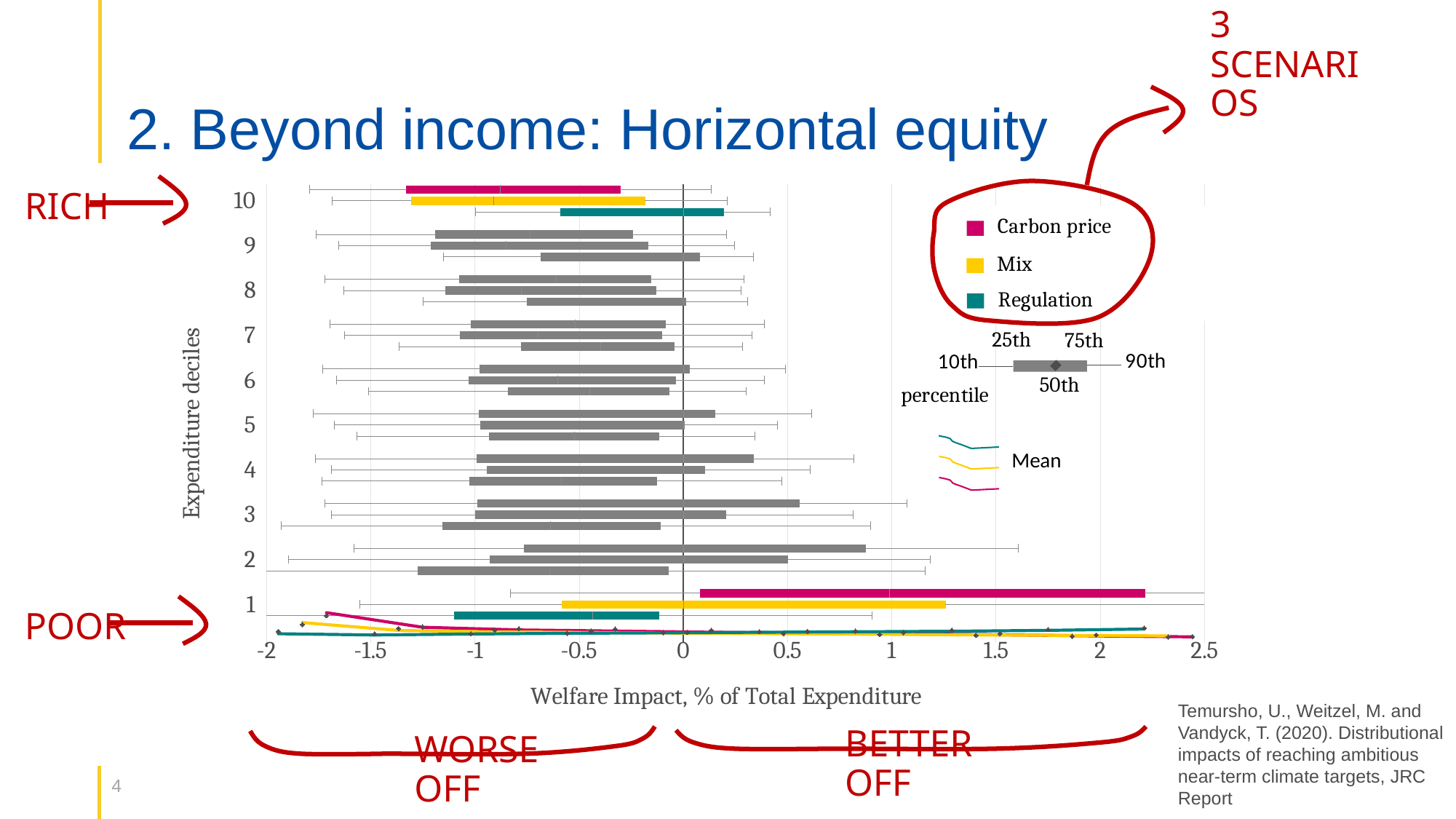
Is the right end of the Mix bar for decile 1 greater or less than 1? greater Is the right end of the Regulation bar for decile 1 greater or less than 0? less Is the right end of the Carbon price bar for decile 1 greater or less than 2? greater Which scenario is shown in yellow in the chart legend? Mix For expenditure decile 10, which scenario's bar extends furthest to the right? Regulation For expenditure decile 1, which scenario's bar extends furthest to the right? Carbon price Which expenditure decile has the Carbon price bar extending furthest to the right? 1 What is the title of the x axis of the chart? Welfare Impact, % of Total Expenditure How many scenarios does the chart legend list? 3 What kind of chart is shown on the slide? bar chart How many expenditure deciles are shown on the y axis of the chart? 10